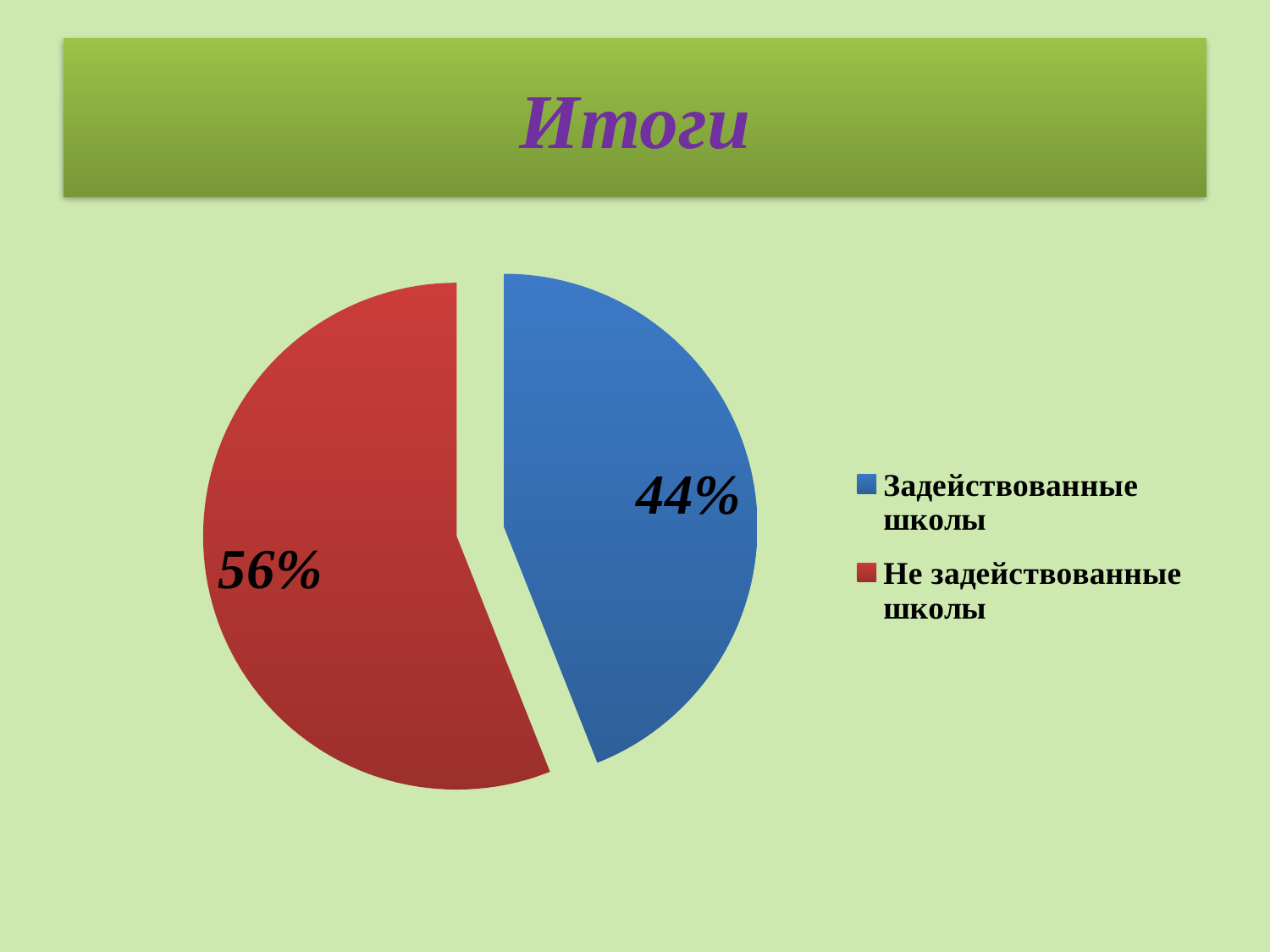
What is the difference in percentage points between the "Не задействованные школы" slice and the "Задействованные школы" slice? 12 What is the title shown at the top of the slide? Итоги What colour is the slice for "Задействованные школы"? blue How many entries does the legend list? 2 Which category has the largest slice of the pie? Не задействованные школы Which category has the smallest slice of the pie? Задействованные школы What kind of chart is shown on the slide? pie chart What share of the pie is labelled "Не задействованные школы"? 56% Which is larger: the share for "Задействованные школы" or the share for "Не задействованные школы"? Не задействованные школы What share of the pie is labelled "Задействованные школы"? 44% How many slices does the pie chart have? 2